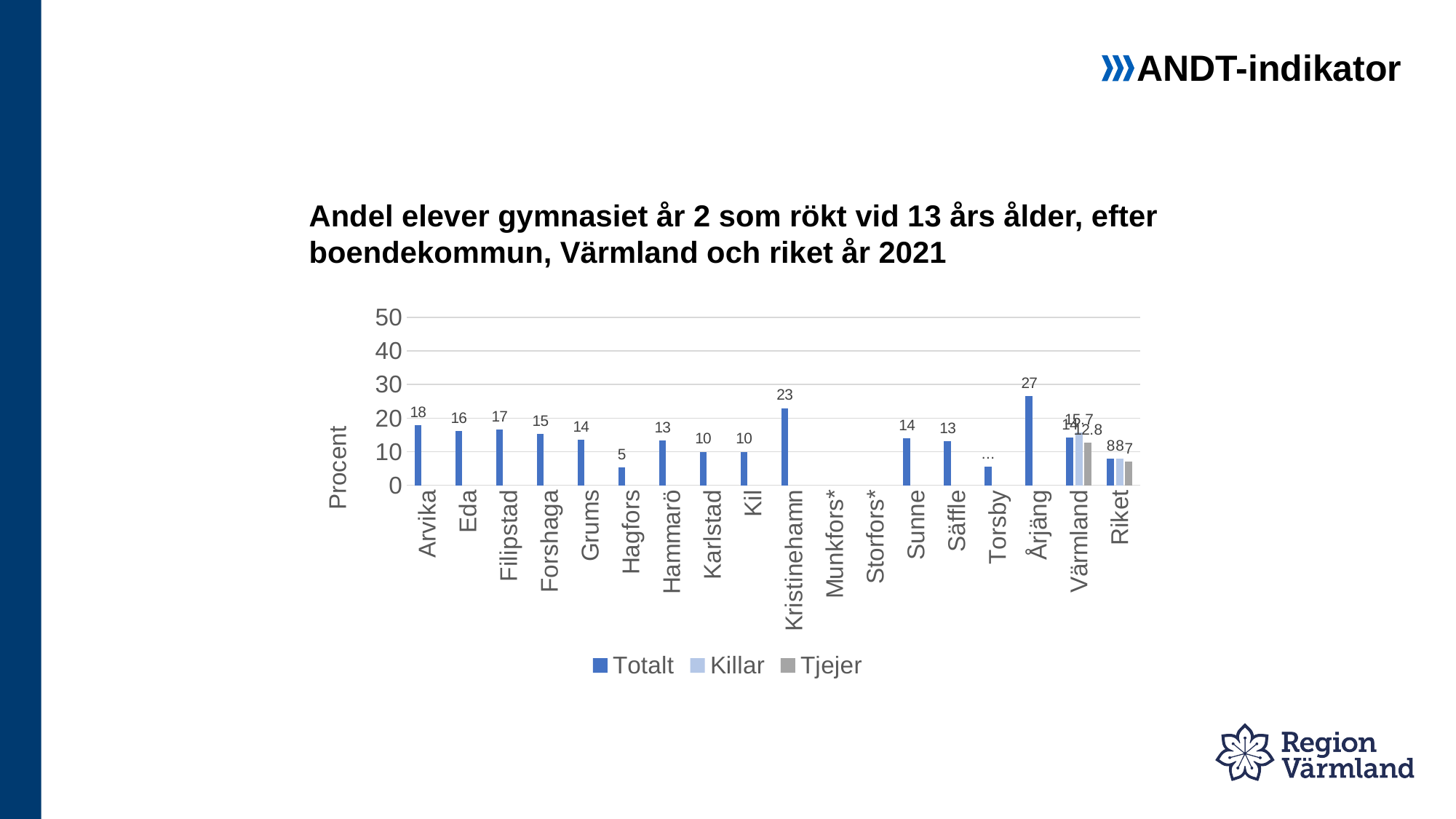
What is the Totalt value for Hagfors? 5 Which municipality has the highest Totalt value? Årjäng What is the label on the y axis? Procent What is the difference between the Totalt values for Årjäng and Kristinehamn? 4 What is the Tjejer value for Riket? 7 Which has the larger Totalt value, Eda or Filipstad? Filipstad What is the Totalt value for Kristinehamn? 23 What is the Killar value for Värmland? 15.7 How many categories are shown on the x axis? 18 Is the Totalt value for Kristinehamn greater or less than 20? greater How many series does the legend list? 3 What kind of chart is shown on the slide? bar chart